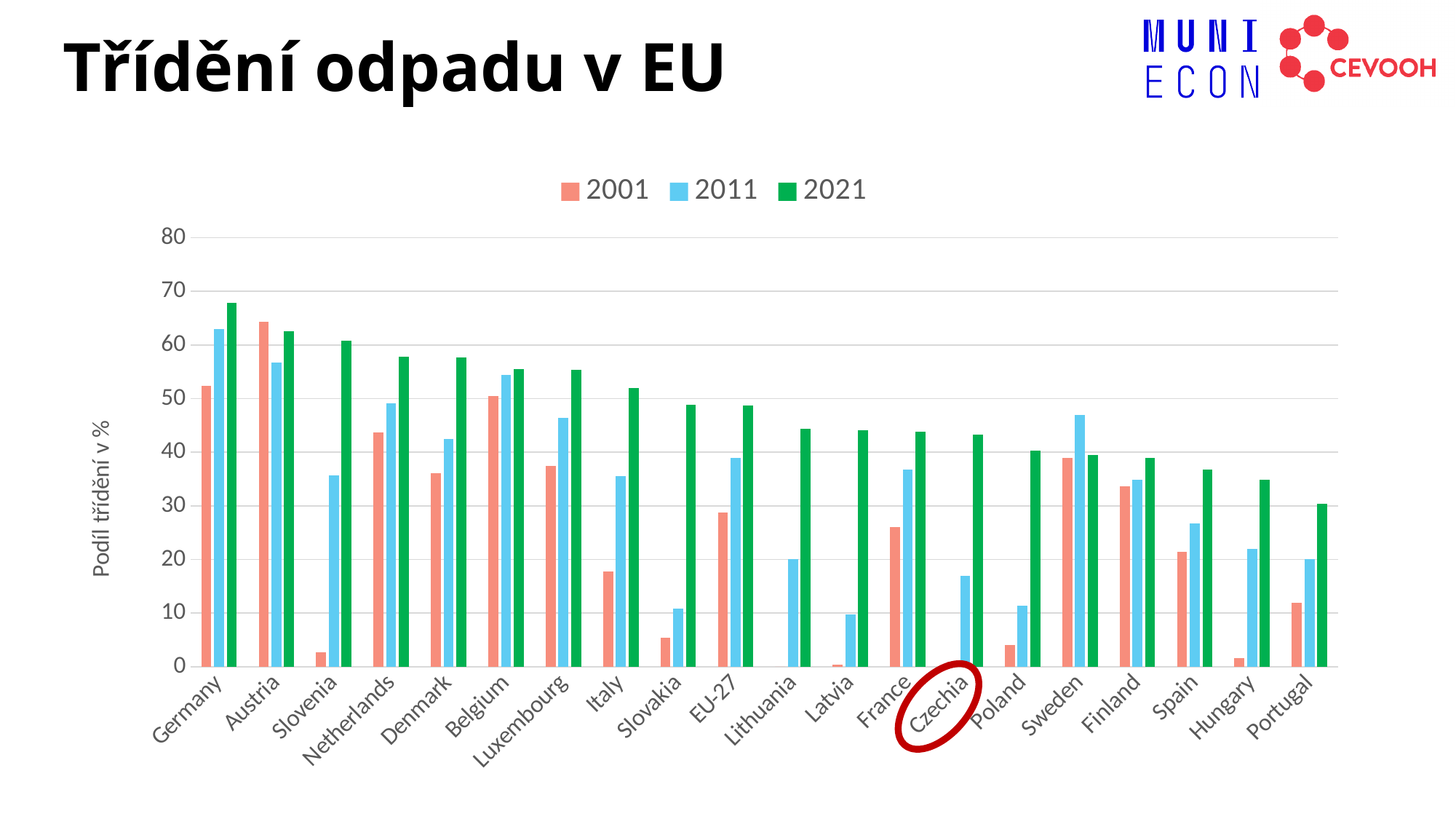
Is the 2011 value for Czechia greater or less than 20? less Which category has the highest value for 2001? Austria How many countries/categories are shown on the x axis? 20 For Sweden, which is larger: the 2011 value or the 2021 value? 2011 Which category on the x axis is circled in red? Czechia What kind of chart is shown on the slide? bar chart Do the 2021 values generally rise or fall moving from left to right along the x axis? fall Is the 2011 value for Sweden greater or less than 40? greater Which category has the highest value for 2021? Germany How many series does the legend list? 3 Is the 2021 value for Czechia greater or less than 40? greater Which category has the lowest value for 2021? Portugal